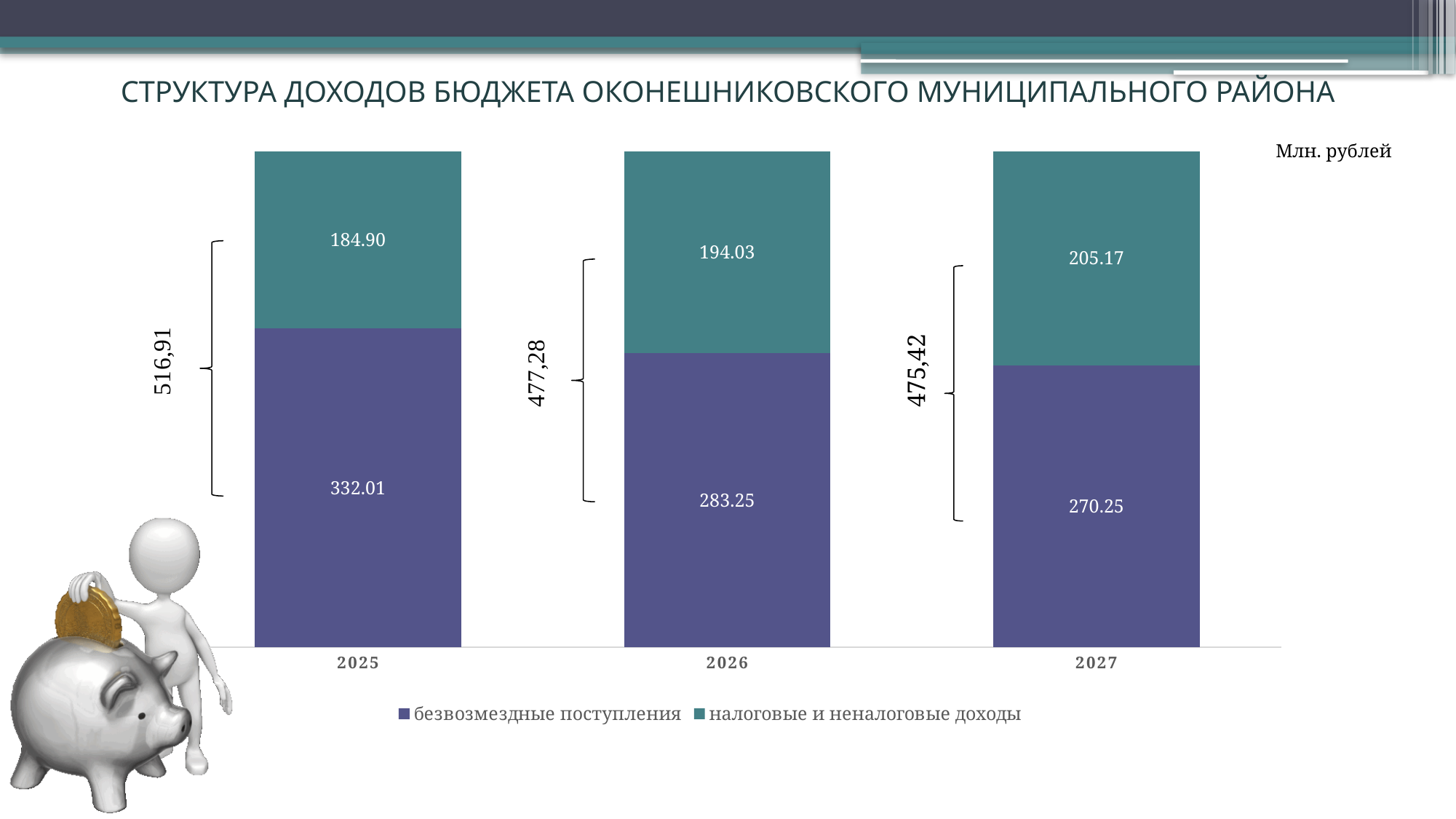
What is the difference between безвозмездные поступления and налоговые и неналоговые доходы in 2027? 65.08 How many years are shown on the x axis? 3 What kind of chart is shown on the slide? stacked bar chart What is the value for налоговые и неналоговые доходы in 2026? 194.03 In which year is the value for безвозмездные поступления the highest? 2025 What is the value for налоговые и неналоговые доходы in 2027? 205.17 Do the values for налоговые и неналоговые доходы rise or fall from 2025 to 2027? rise How many series does the legend list? 2 What is the total of the stacked bar for 2026? 477,28 Which is larger in 2026: безвозмездные поступления or налоговые и неналоговые доходы? безвозмездные поступления What is the value for безвозмездные поступления in 2025? 332.01 In which year is the value for налоговые и неналоговые доходы the lowest? 2025